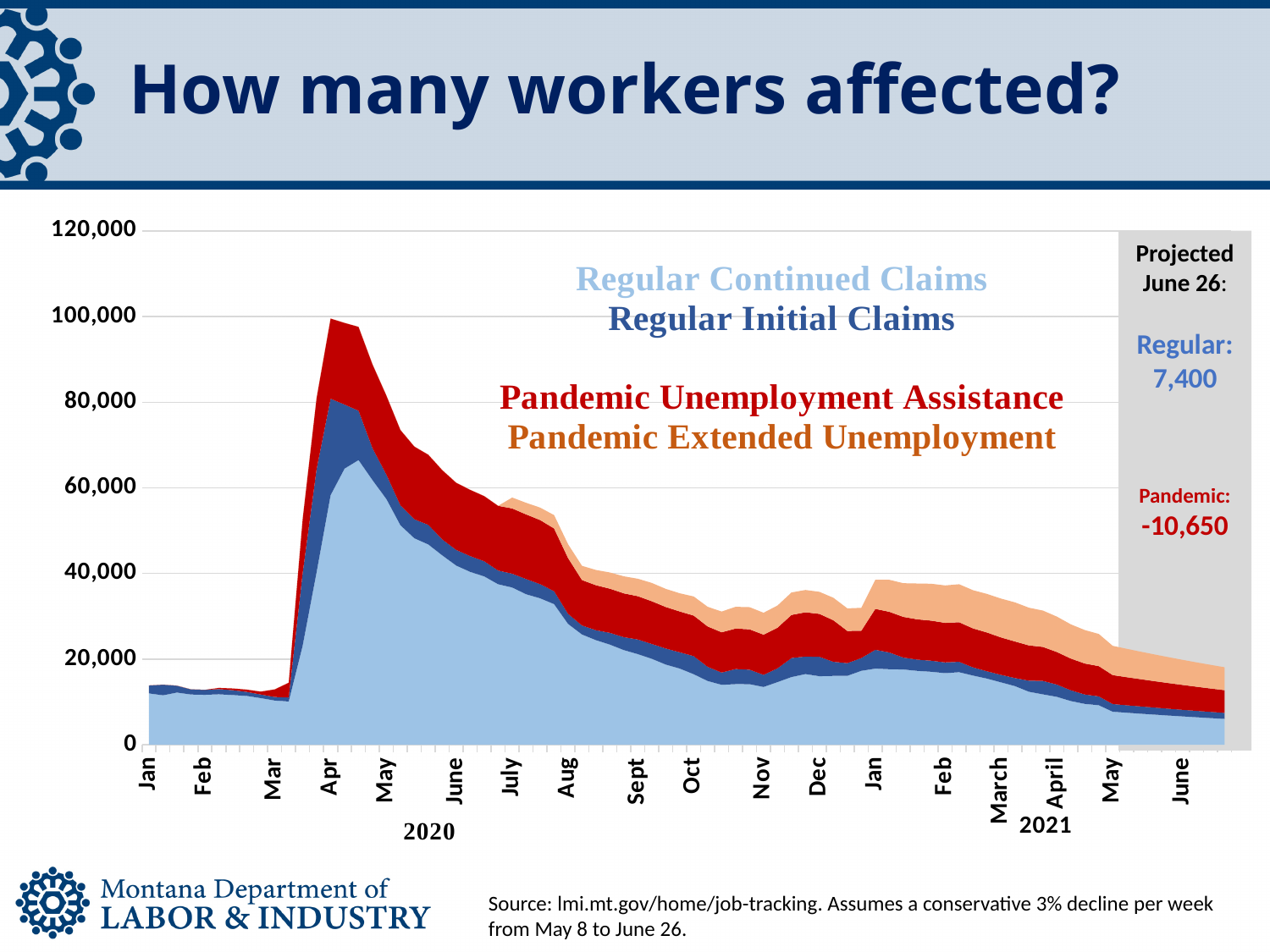
In which month of 2020 does the total stacked value reach its peak? Apr From the April 2020 peak to June 2021, do the total values rise or fall? fall Which series is shown in light blue at the bottom of the stacked area chart? Regular Continued Claims What kind of chart is shown on the slide? stacked area chart What is the projected Pandemic value for June 26? -10,650 Is the total value in June 2021 greater or less than 40,000? less Is the peak total value in April 2020 greater or less than 80,000? greater What is the projected Regular claims value for June 26? 7,400 Which series is shown in red on the chart? Pandemic Unemployment Assistance How many series does the chart's legend list? 4 Is the total value in April 2020 larger than the total value in April 2021? April 2020 Is the total value in January 2020 greater or less than 20,000? less